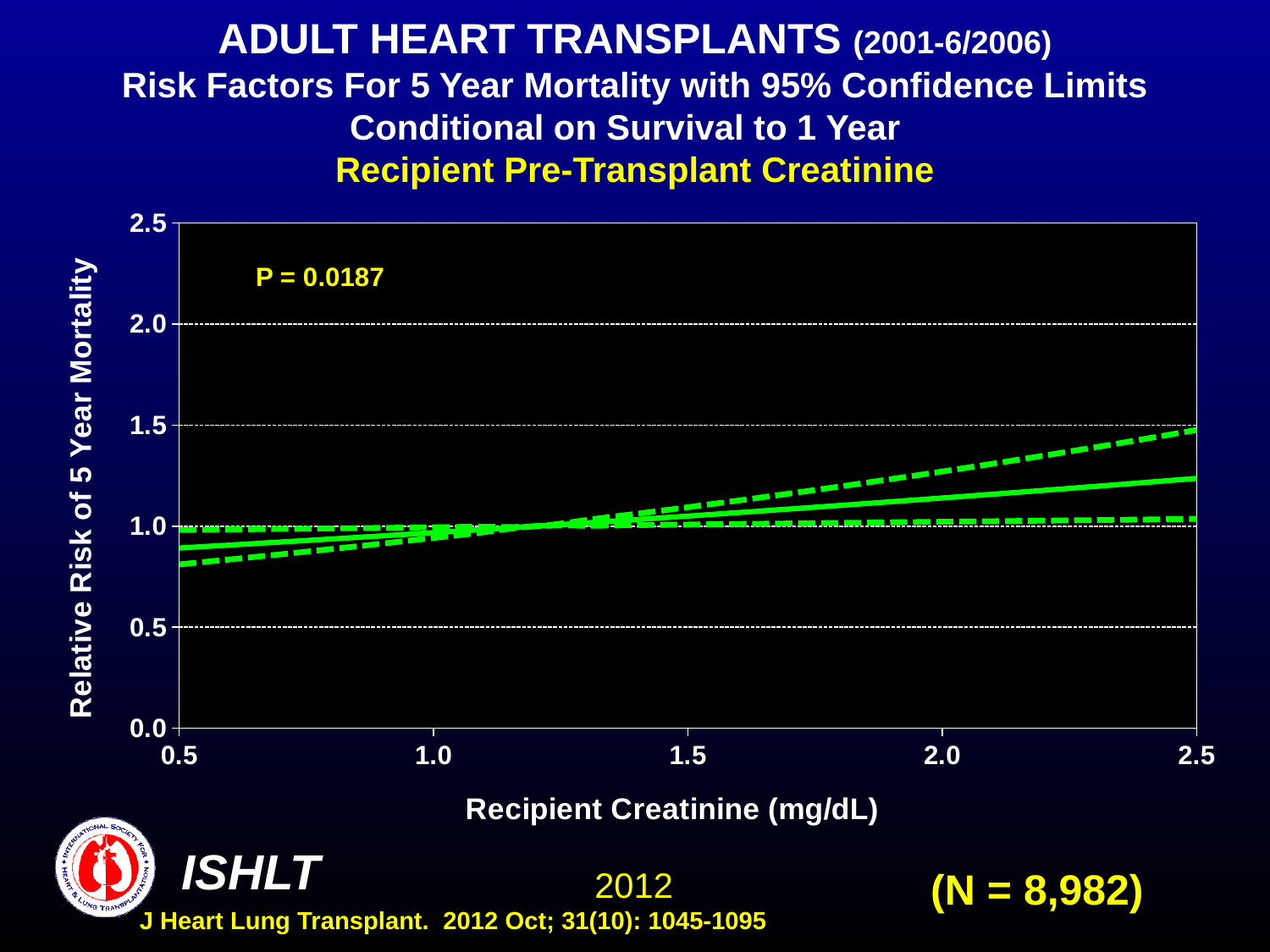
How many lines are plotted on the chart? 3 What P value is printed on the chart? P = 0.0187 Is the solid relative risk line at a recipient creatinine of 2.5 mg/dL greater or less than 1.0? greater What sample size (N) is shown on the slide? N = 8,982 What kind of chart is shown on the slide? line chart Is the solid relative risk line at a recipient creatinine of 2.0 mg/dL greater or less than 1.0? greater Is the upper dashed confidence limit at a recipient creatinine of 2.5 mg/dL greater or less than 1.0? greater Does the solid relative risk line rise or fall as recipient creatinine increases from 0.5 to 2.5 mg/dL? rise What is the label of the x axis? Recipient Creatinine (mg/dL) What colour are the plotted lines? green